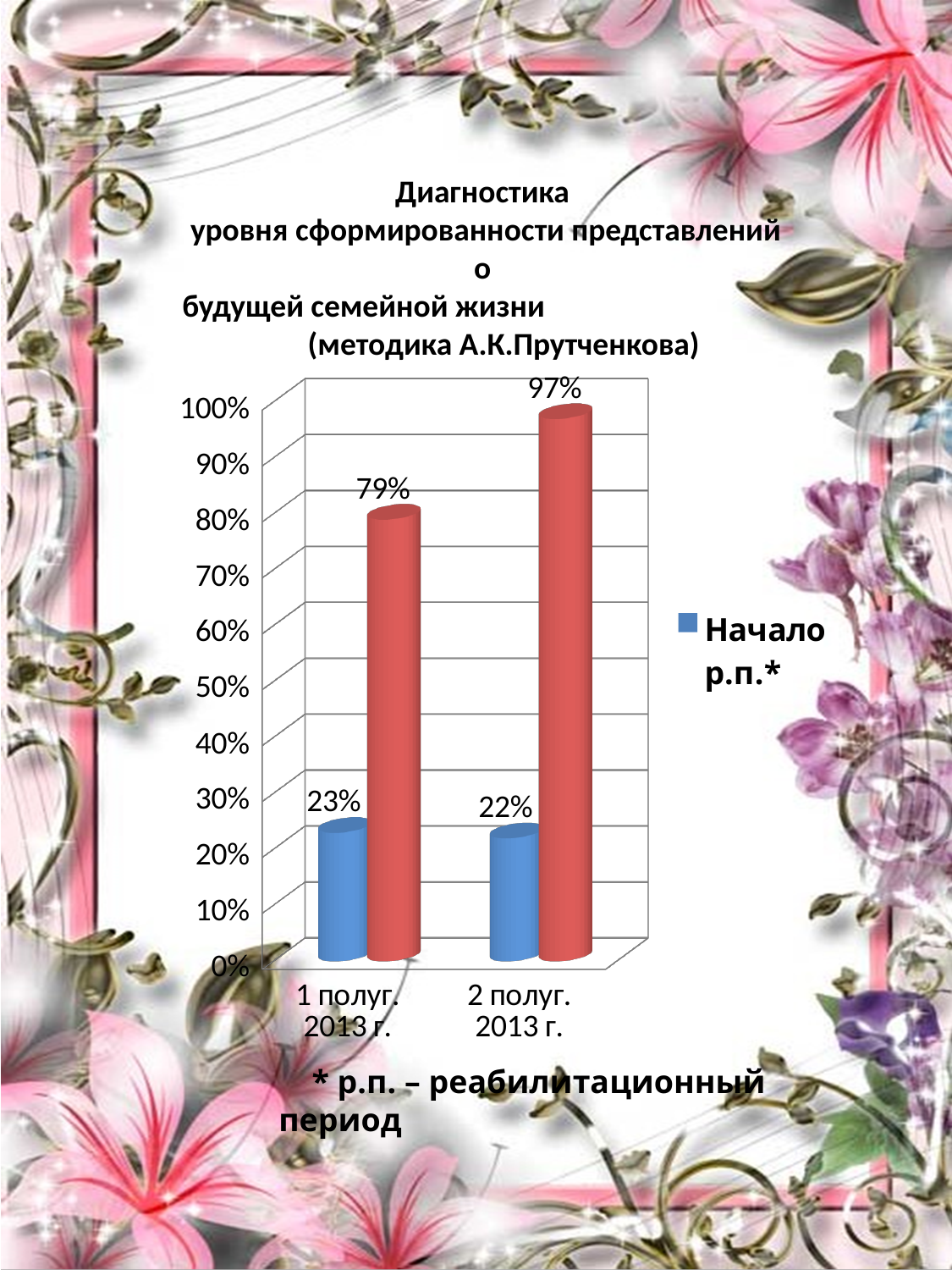
How many categories are shown on the x axis? 2 What is the difference between the Начало р.п.* values for 1 полуг. 2013 г. and 2 полуг. 2013 г.? 1% For 1 полуг. 2013 г., which is larger: the blue bar or the red bar? the red bar Which category has the higher red bar? 2 полуг. 2013 г. Do the red bar values rise or fall from 1 полуг. 2013 г. to 2 полуг. 2013 г.? rise What is the value of the Начало р.п.* series for 2 полуг. 2013 г.? 22% What kind of chart is shown on the slide? bar chart What value is labelled on the red bar for 1 полуг. 2013 г.? 79% Is the red bar for 2 полуг. 2013 г. greater or less than 90%? greater What is the value of the Начало р.п.* series for 1 полуг. 2013 г.? 23% What is the difference between the red bar values for 2 полуг. 2013 г. and 1 полуг. 2013 г.? 18% What value is labelled on the red bar for 2 полуг. 2013 г.? 97%